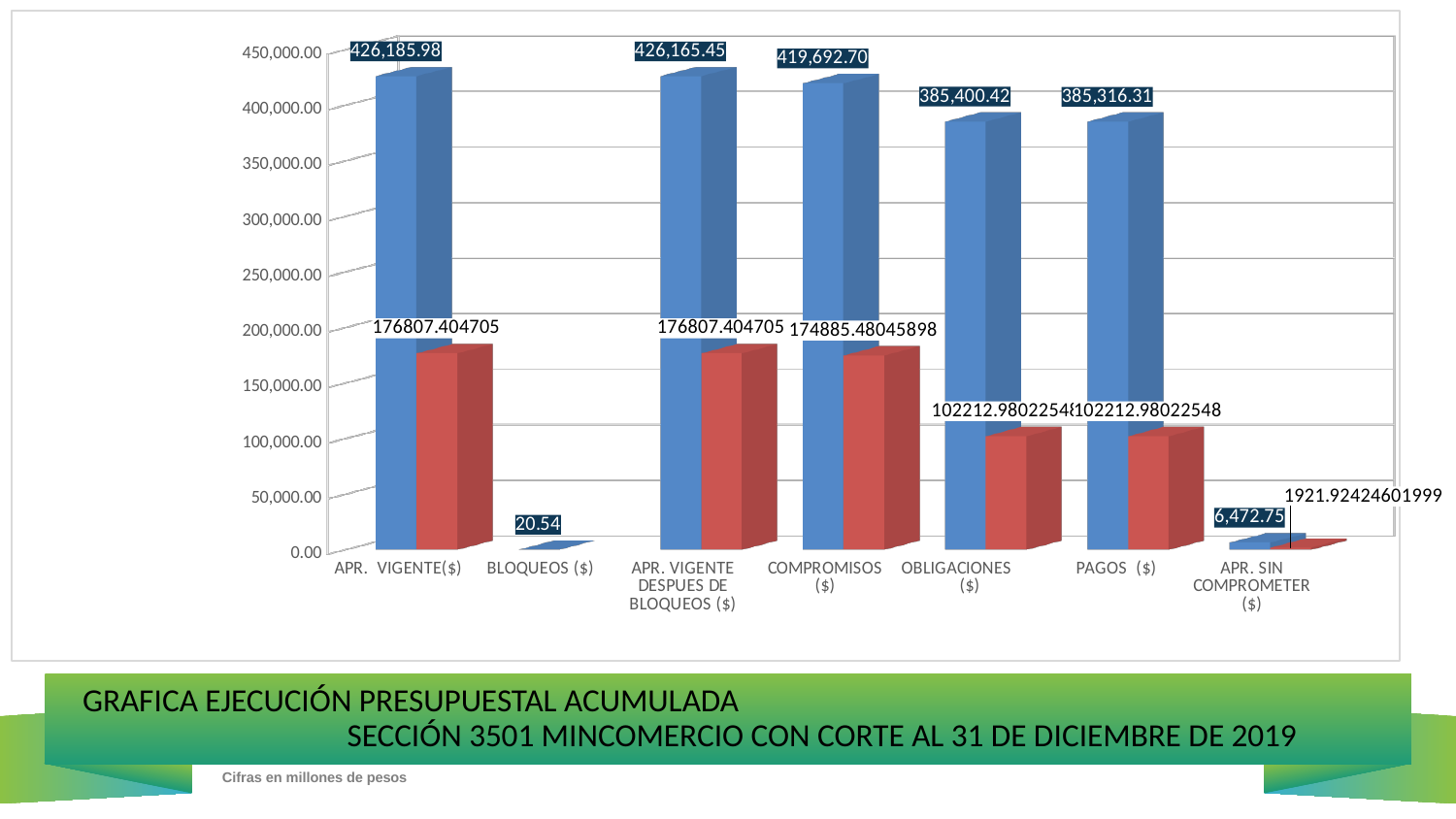
What is the difference between the blue bars for APR. VIGENTE($) and APR. VIGENTE DESPUES DE BLOQUEOS ($)? 20.53 What is the difference between the blue bars for COMPROMISOS ($) and OBLIGACIONES ($)? 34,292.28 Which is larger, the blue bar for COMPROMISOS ($) or the blue bar for PAGOS ($)? COMPROMISOS ($) What is the value of the blue bar for APR. VIGENTE($)? 426,185.98 What type of chart is shown on the slide? Bar chart What is the value of the blue bar for BLOQUEOS ($)? 20.54 What is the value of the blue bar for COMPROMISOS ($)? 419,692.70 What is the value of the red bar for APR. SIN COMPROMETER ($)? 1921.92424601999 Is the blue bar for OBLIGACIONES ($) greater or less than 400,000.00? less What is the value of the red bar for COMPROMISOS ($)? 174885.48045898 Which category has the lowest blue bar? BLOQUEOS ($) How many categories are shown on the x axis? 7